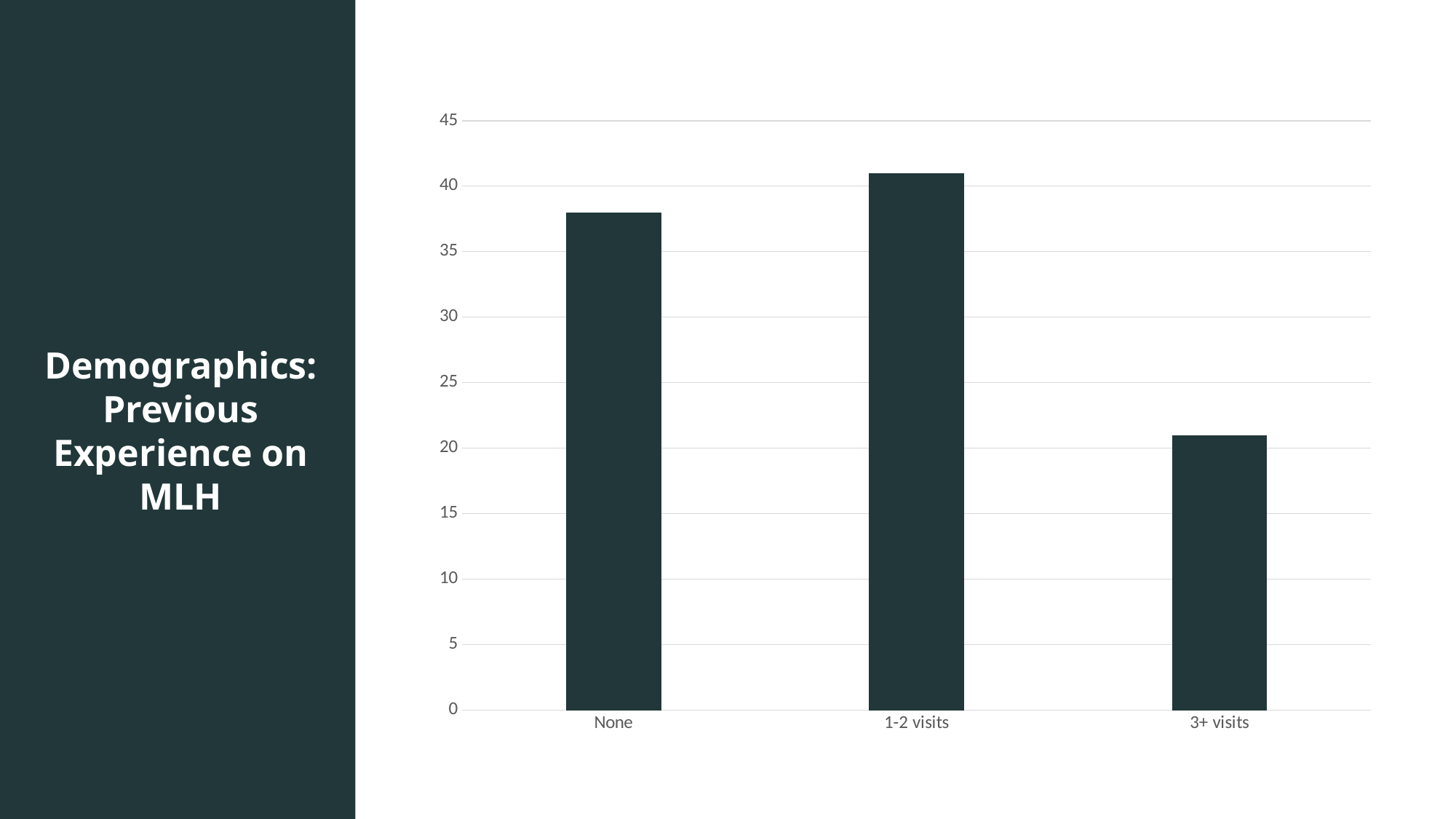
Which category has the lowest bar in the chart? 3+ visits Which is larger, the value for None or the value for 3+ visits? None Which category has the highest bar in the chart? 1-2 visits Is the value for 1-2 visits greater or less than 40? greater Which is larger, the value for 1-2 visits or the value for 3+ visits? 1-2 visits What kind of chart is shown on the slide? bar chart How many categories are shown on the x axis of the chart? 3 Is the value for None greater or less than 40? less Is the value for None greater or less than 35? greater What is the highest value shown on the y axis of the chart? 45